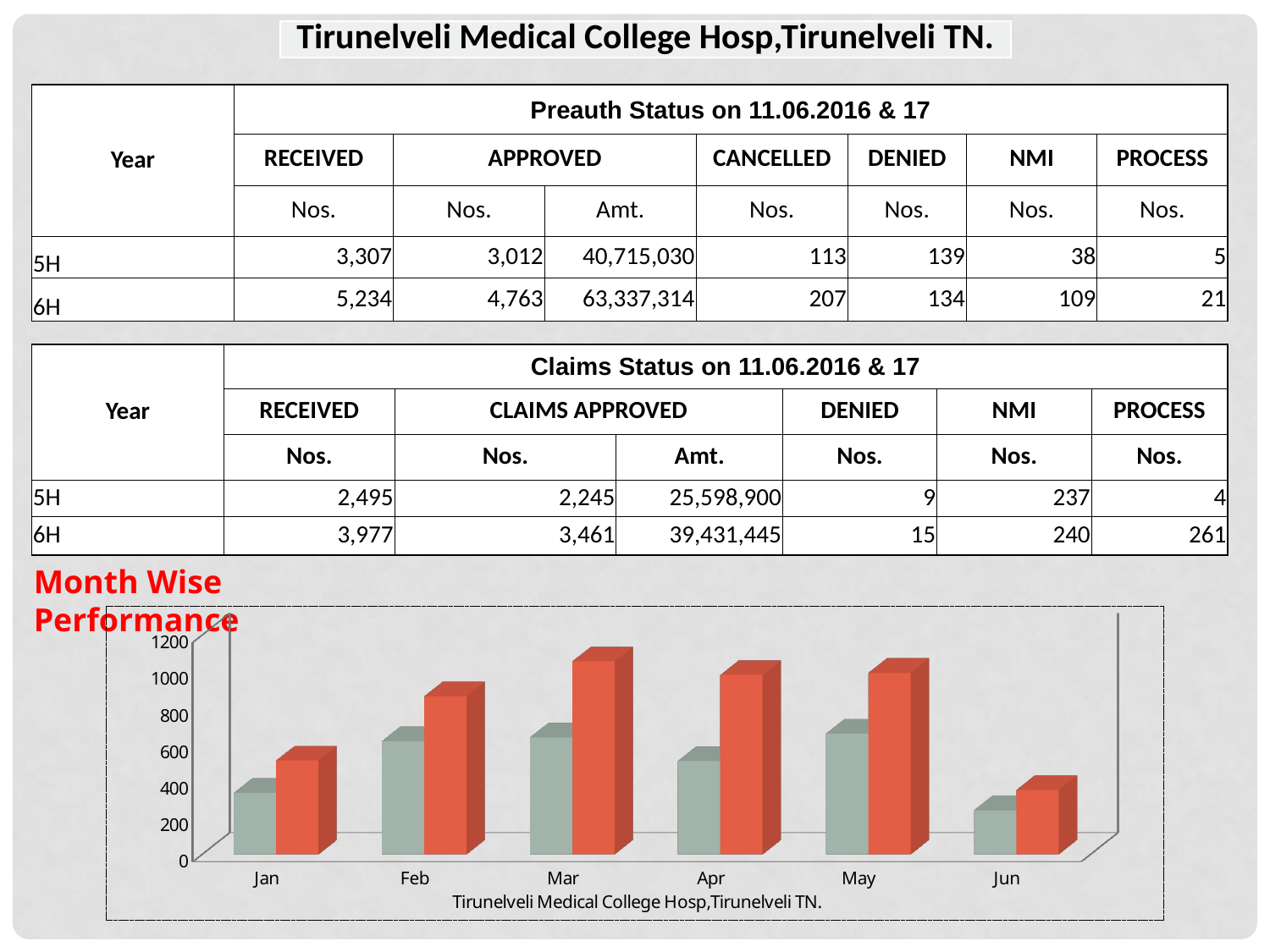
In the bar chart, is the red bar for Mar greater or less than 800? greater In the bar chart, which month has the shortest red bar? Jun In the bar chart, do the values rise or fall from May to Jun? fall What kind of chart is shown under the heading 'Month Wise Performance'? bar chart In the bar chart, which month has the shortest grey bar? Jun How many months are shown on the x axis of the bar chart? 6 In the bar chart, is the red bar for Jun greater or less than 600? less In the bar chart, is the grey bar for Jan greater or less than 600? less In the bar chart, which is larger: the red bar for Jan or the red bar for Jun? Jan In the bar chart, which month has the tallest red bar? Mar What text appears as the axis title below the months in the bar chart? Tirunelveli Medical College Hosp,Tirunelveli TN.